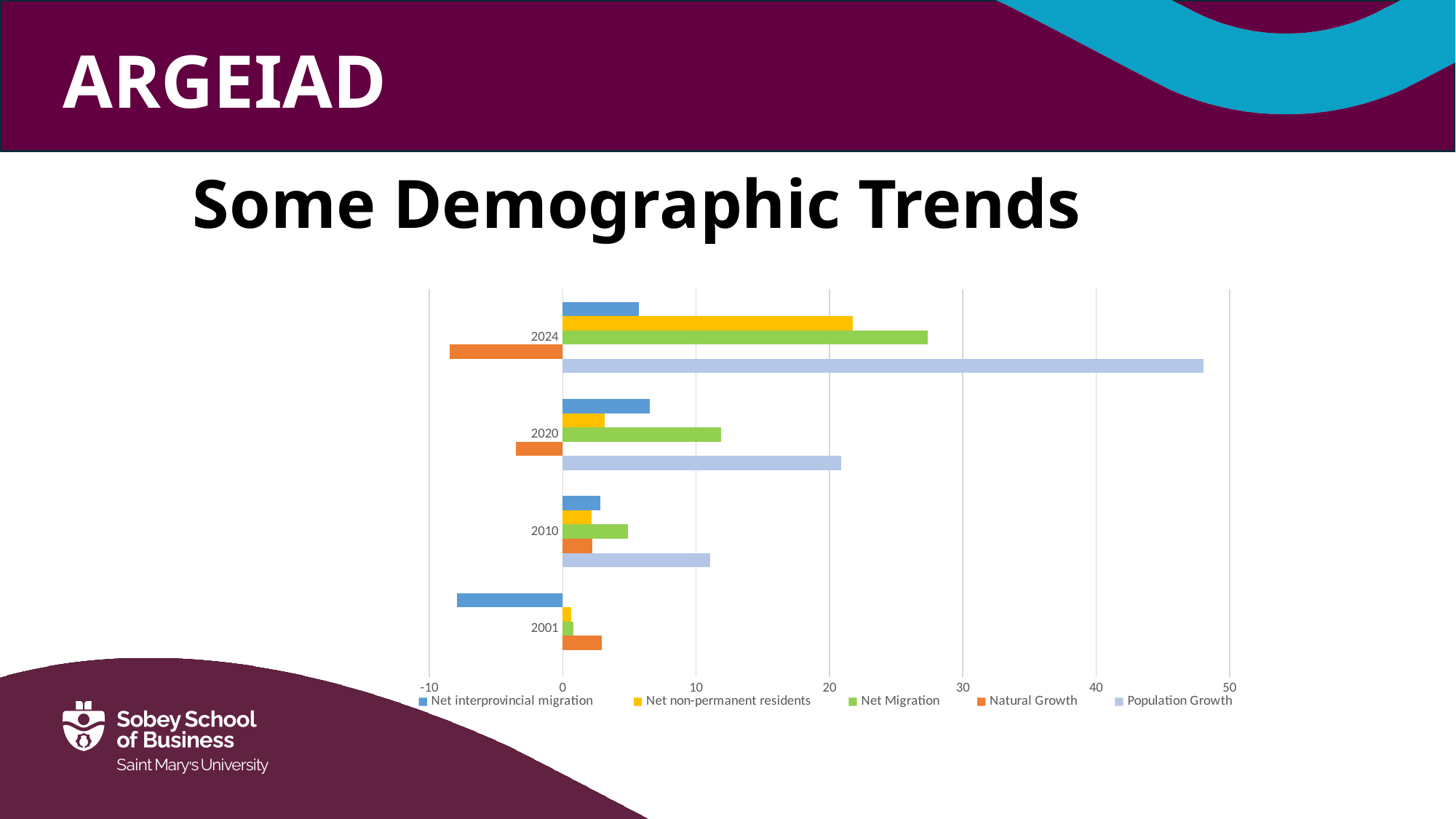
How many years (categories) are shown on the chart? 4 Which is larger in 2024: Net Migration or Net non-permanent residents? Net Migration Which year has the highest Population Growth value? 2024 Which series has the lowest value in 2024? Natural Growth Is the Net Migration value for 2024 greater or less than 20? greater Is the Net interprovincial migration value for 2001 greater or less than 0? less Which series has the highest value in 2024? Population Growth Is the Population Growth value for 2024 greater or less than 40? greater How many series does the chart legend list? 5 Which series is shown in orange in the legend? Natural Growth What kind of chart is shown on the slide? Bar chart